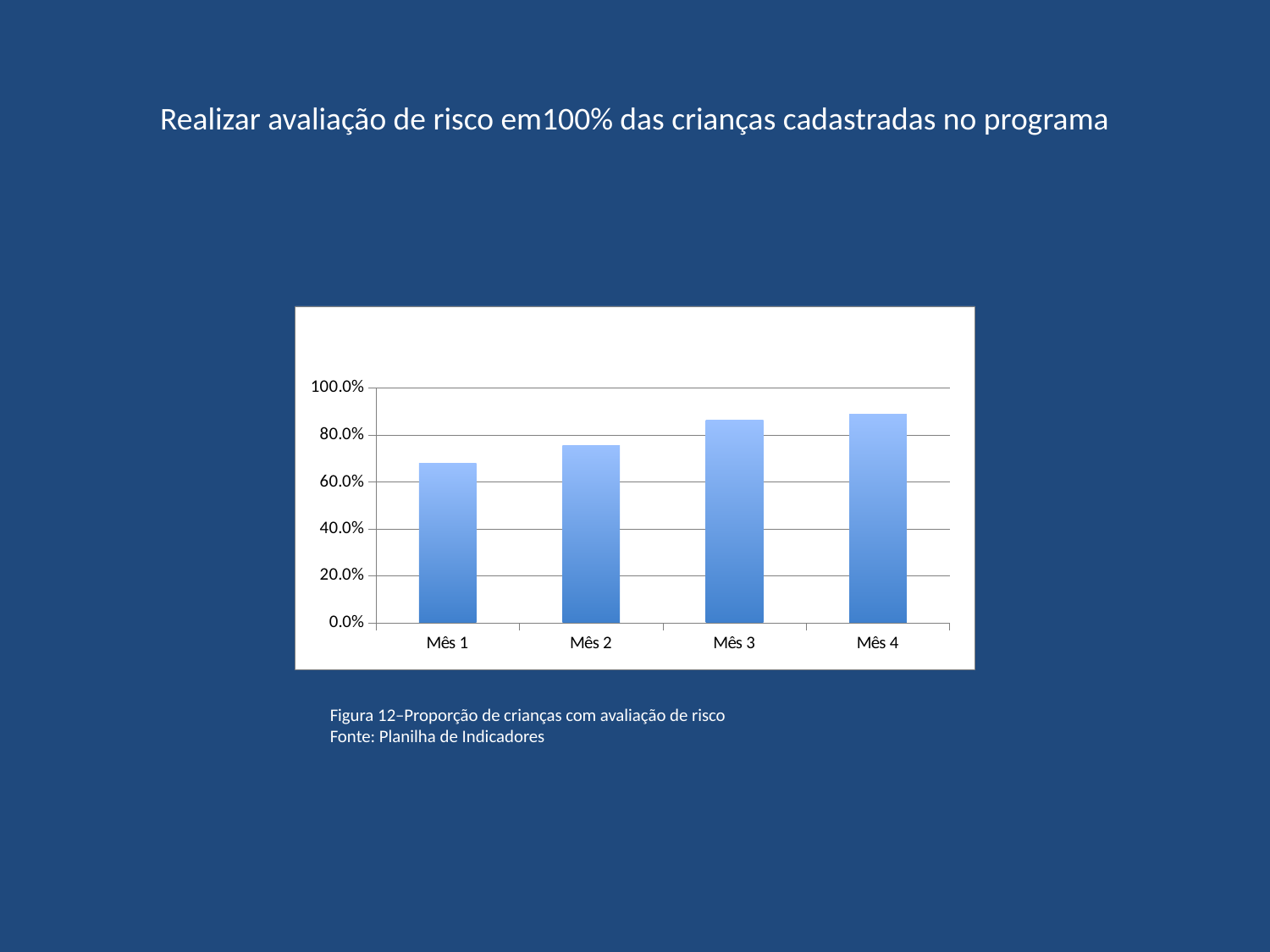
Is the value for Mês 3 greater or less than 80.0%? greater Is the value for Mês 1 greater or less than 80.0%? less Is the value for Mês 2 greater or less than 80.0%? less According to the caption below the chart, what is the source of the data? Planilha de Indicadores Which is larger, the value for Mês 2 or the value for Mês 4? Mês 4 Do the values rise or fall from Mês 1 to Mês 4? rise What kind of chart is shown on the slide? bar chart Which month has the lowest bar? Mês 1 How many months (categories) are plotted on the x axis? 4 Which is larger, the value for Mês 1 or the value for Mês 3? Mês 3